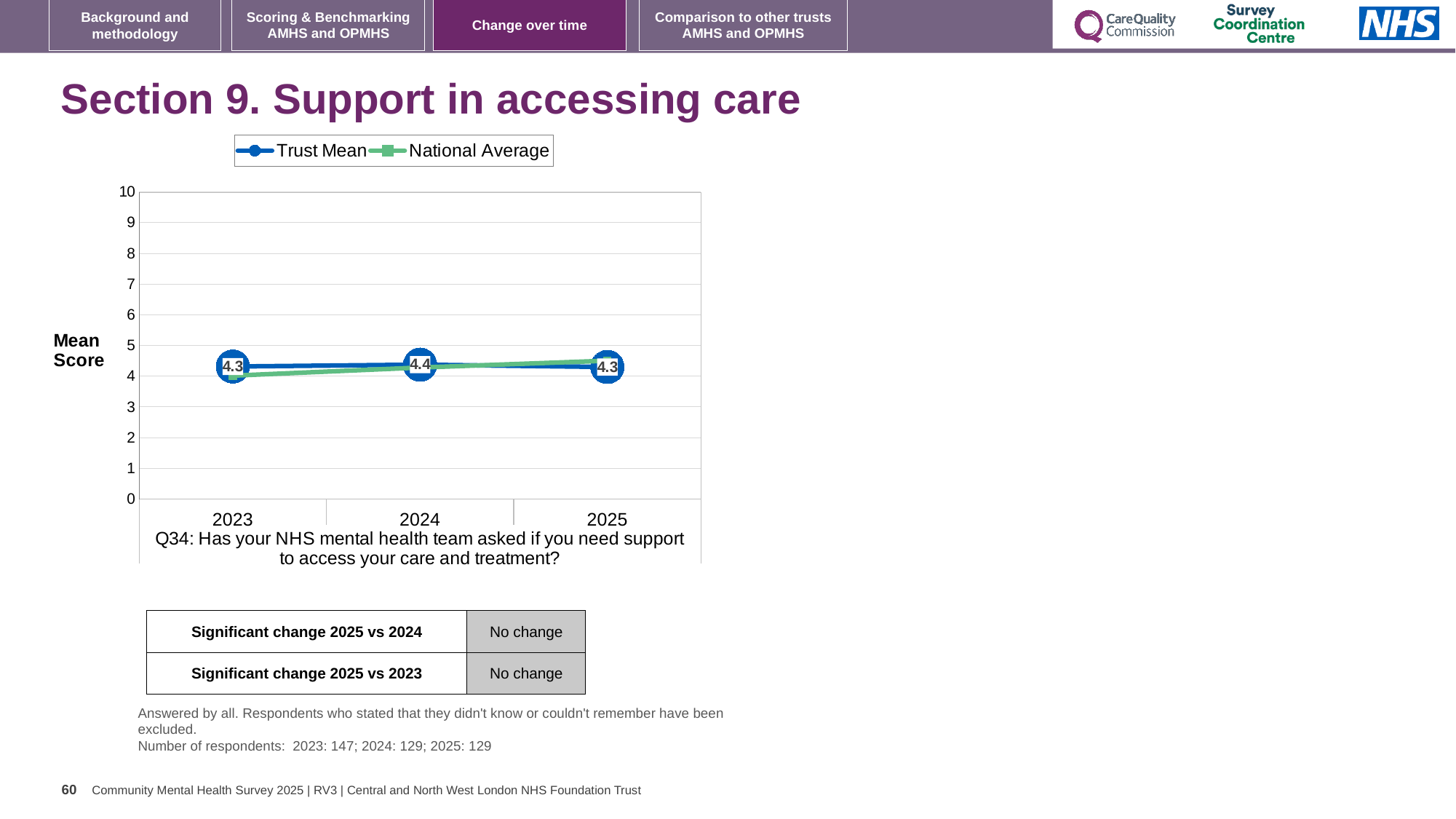
What is the Trust Mean score for 2024? 4.4 What is the Trust Mean score for 2025? 4.3 What is the difference between the Trust Mean scores for 2024 and 2023? 0.1 Is the National Average value for 2025 greater or less than 3? greater In which year is the Trust Mean score highest? 2024 Which is larger, the Trust Mean score for 2024 or for 2025? 2024 What is the Trust Mean score for 2023? 4.3 How many years are plotted on the x axis? 3 What kind of chart is shown on the slide? line chart What is the label on the y axis of the chart? Mean Score How many series does the legend list? 2 Is the National Average value for 2023 greater or less than 5? less